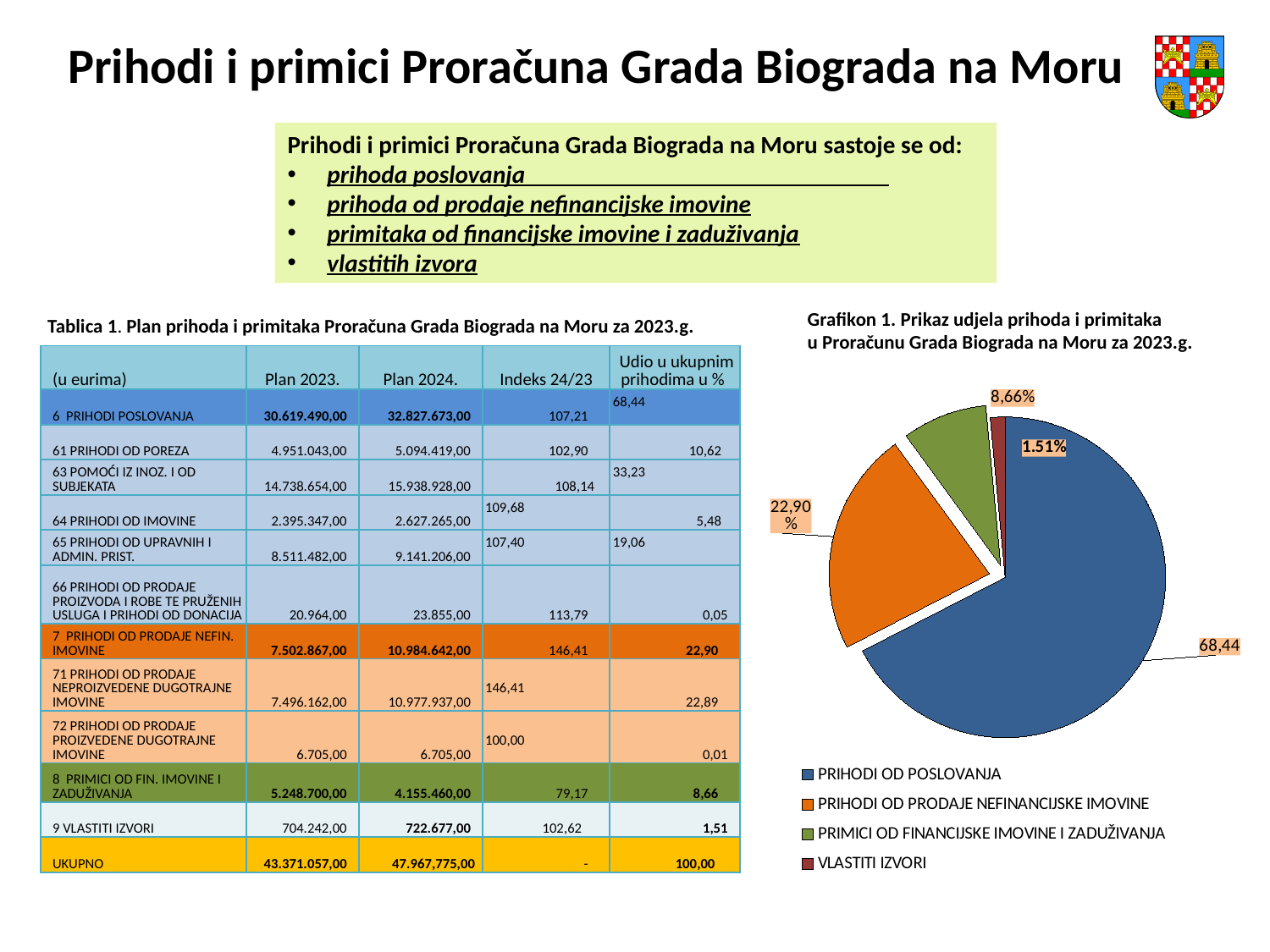
What is the value shown for PRIHODI OD POSLOVANJA in the pie chart? 68,44 What is the value shown for PRIHODI OD PRODAJE NEFINANCIJSKE IMOVINE in the pie chart? 22,90 % What is the value shown for VLASTITI IZVORI in the pie chart? 1.51% Which category has the smallest slice in the pie chart? VLASTITI IZVORI How many slices does the pie chart have? 4 What kind of chart is shown on the slide? pie chart Which category has the largest slice in the pie chart? PRIHODI OD POSLOVANJA What colour is the slice for PRIHODI OD POSLOVANJA in the pie chart? blue What is the title of the pie chart? Grafikon 1. Prikaz udjela prihoda i primitaka u Proračunu Grada Biograda na Moru za 2023.g. In the pie chart, which is larger: PRIHODI OD PRODAJE NEFINANCIJSKE IMOVINE or PRIMICI OD FINANCIJSKE IMOVINE I ZADUŽIVANJA? PRIHODI OD PRODAJE NEFINANCIJSKE IMOVINE What is the value shown for PRIMICI OD FINANCIJSKE IMOVINE I ZADUŽIVANJA in the pie chart? 8,66% How many entries does the legend of the pie chart list? 4